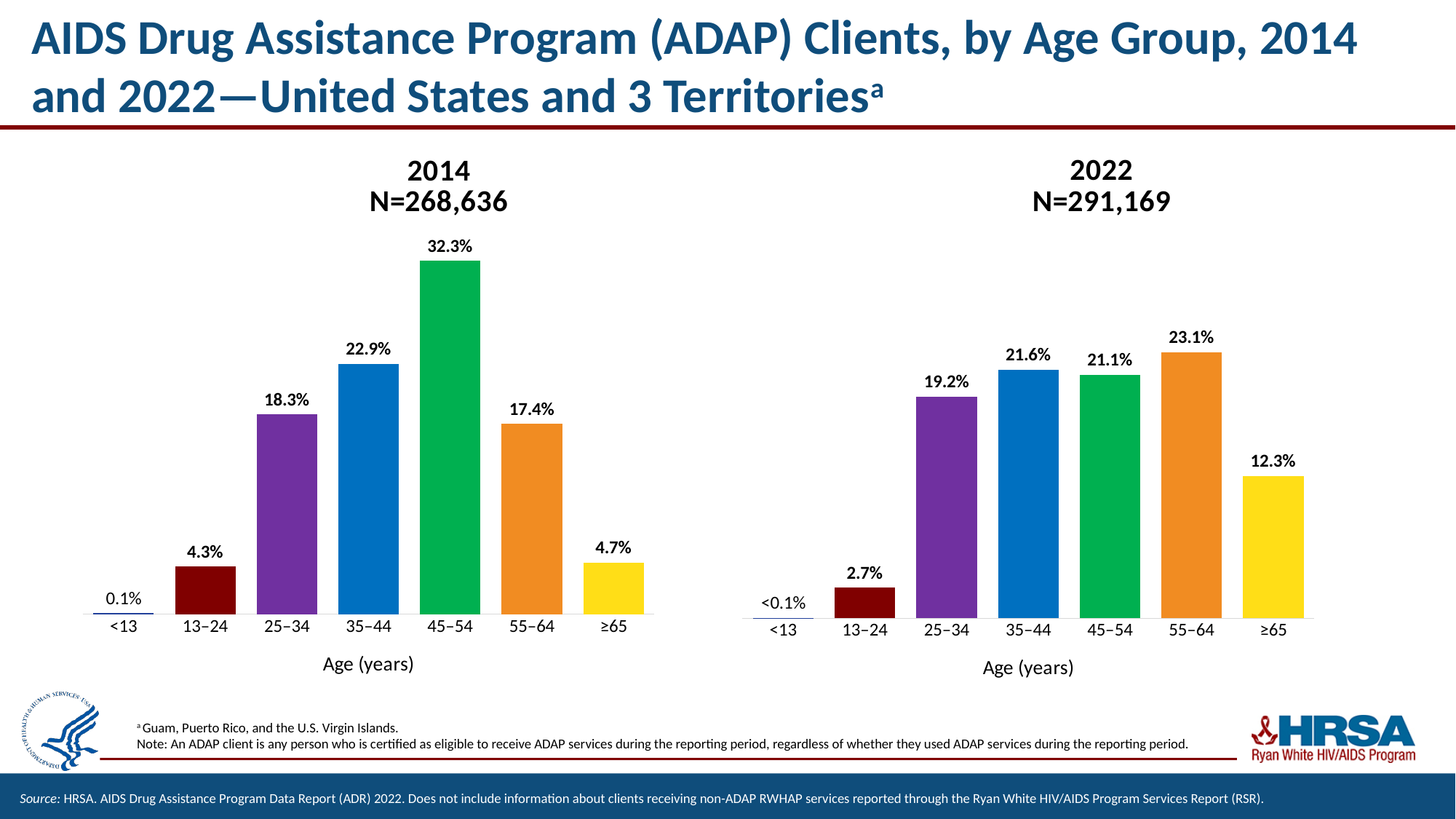
In the 2022 chart, what percentage of ADAP clients were aged ≥65? 12.3% How many age groups are shown in the 2022 chart? 7 What is the total number of clients (N) shown for the 2022 chart? 291,169 In the 2014 chart, what is the difference between the percentages for the 45–54 and 35–44 age groups? 9.4% In the 2014 chart, which is larger: the percentage for 25–34 or for 55–64? 25–34 In the 2014 chart, which age group has the highest percentage? 45–54 In the 2022 chart, what is the difference between the percentages for the ≥65 and 13–24 age groups? 9.6% In the 2014 chart, what percentage of ADAP clients were aged 45–54? 32.3% In the 2022 chart, which age group has the highest percentage? 55–64 What kind of chart is used to show the 2014 data? Bar chart In the 2022 chart, what percentage of ADAP clients were aged 55–64? 23.1% In the 2014 chart, which age group has the lowest percentage? <13